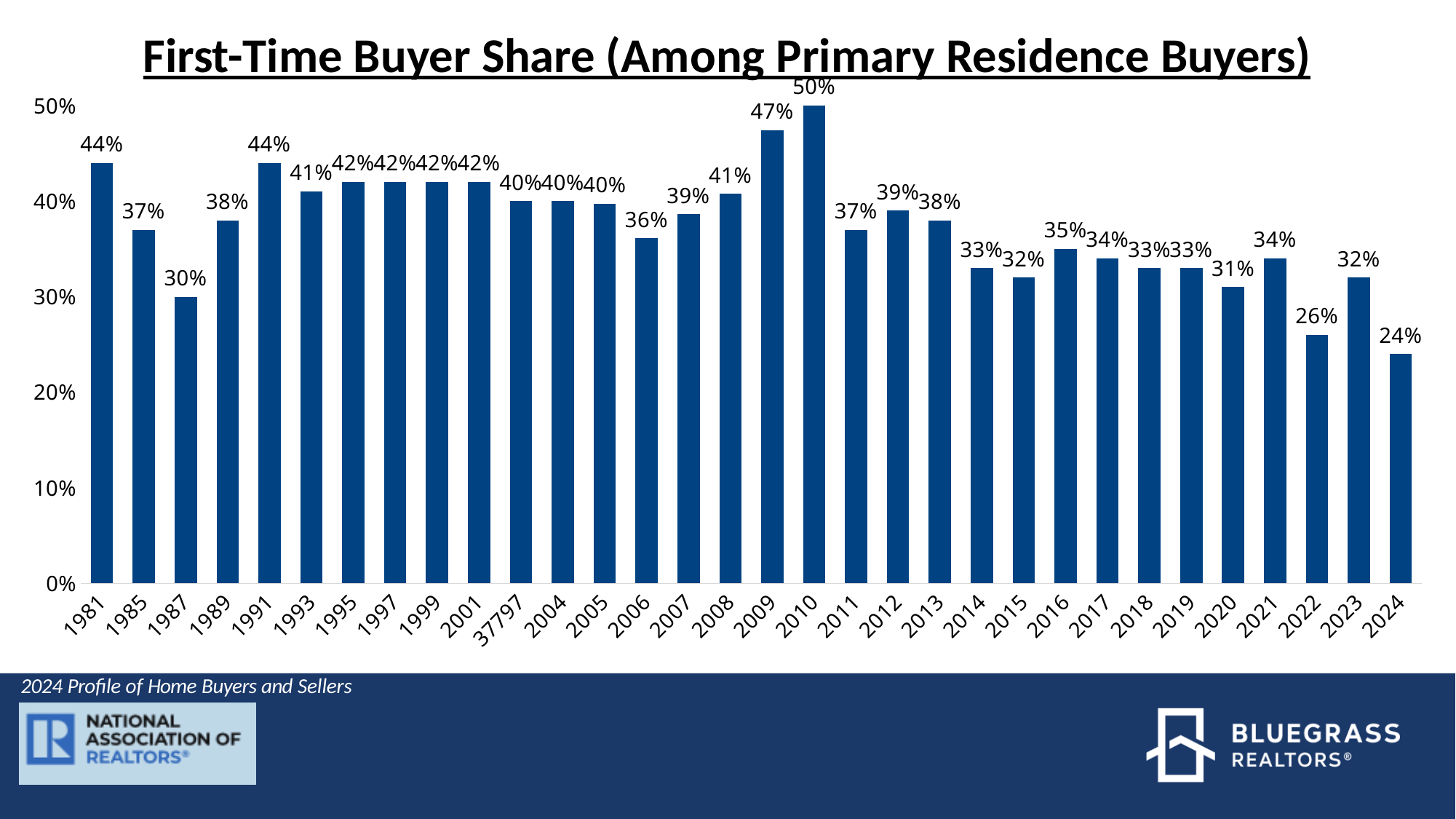
What is the first-time buyer share for 2022? 26% Which year has the highest first-time buyer share? 2010 What is the difference between the first-time buyer share in 2023 and in 2022? 6% Which year has the lowest first-time buyer share? 2024 What is the first-time buyer share for 2010? 50% How many bars are shown in the chart? 32 What is the difference between the first-time buyer share in 2010 and in 2024? 26% What type of chart is shown on the slide? Bar chart What is the first-time buyer share for 1987? 30% Which year has a larger first-time buyer share, 2009 or 2011? 2009 What is the title of the chart? First-Time Buyer Share (Among Primary Residence Buyers) What is the first-time buyer share for 2024? 24%